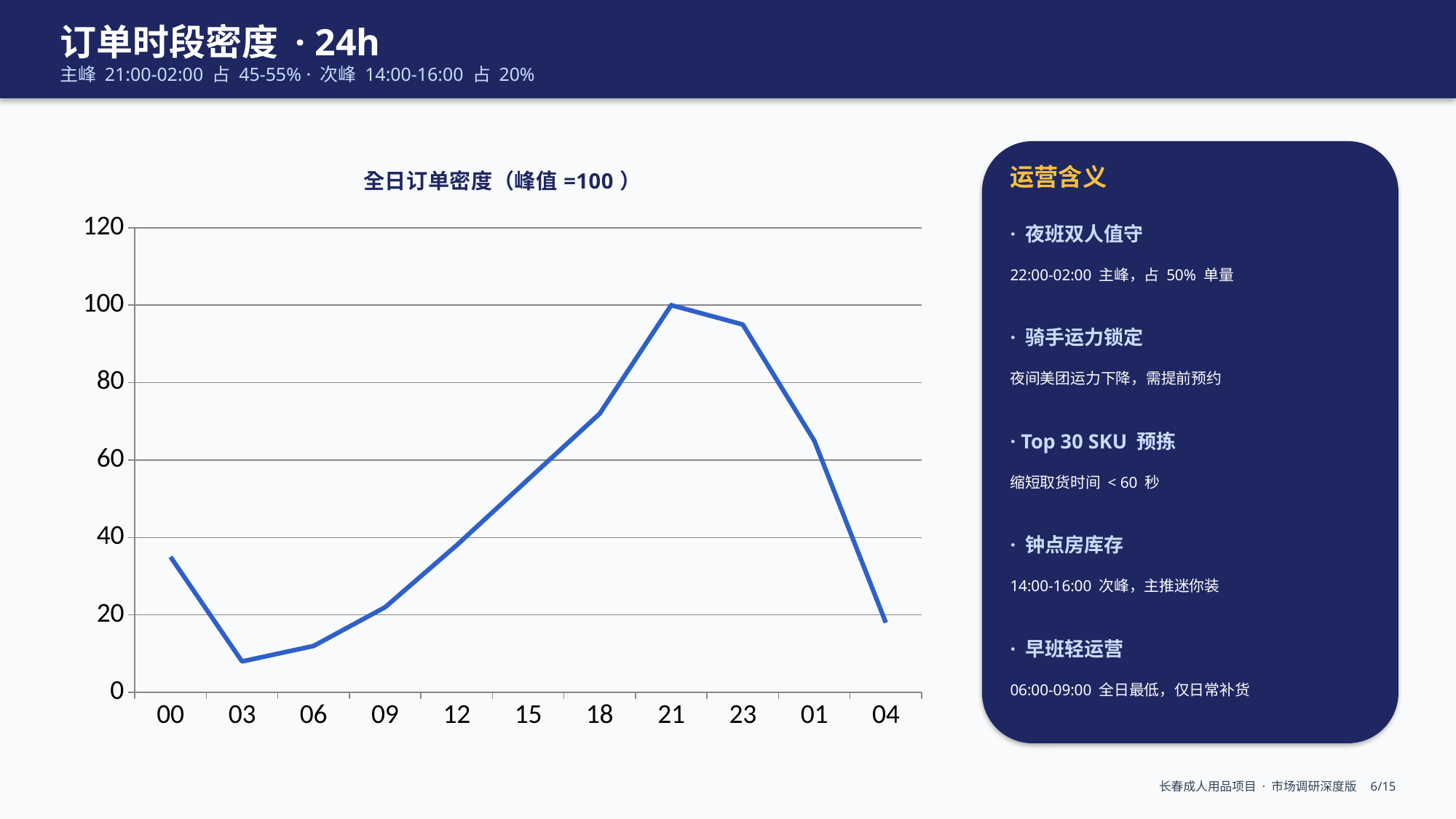
What kind of chart is shown on the slide? line chart Does the order density rise or fall from 03 to 21? rise At which time label does the order density reach its highest value? 21 What is the title of the chart? 全日订单密度（峰值 =100） Is the value at 00 greater or less than 40? less Which has the higher order density, 00 or 04? 00 Is the value at 06 greater or less than 20? less Is the value at 18 greater or less than 60? greater What is the order density value at 21? 100 At which time label is the order density lowest? 03 How many time points are plotted along the x axis of the chart? 11